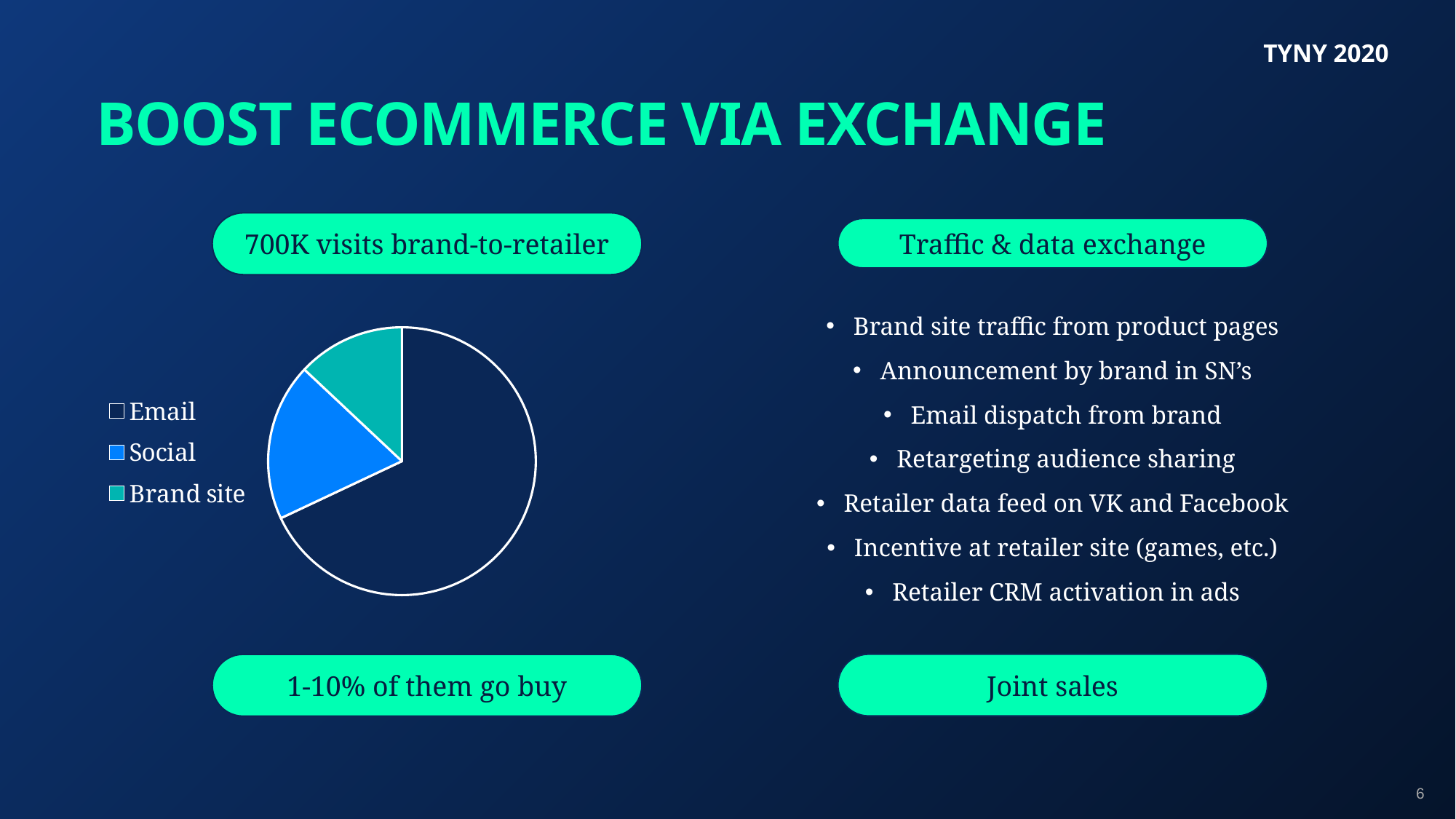
How many slices does the pie chart have? 3 Which slice is larger in the pie chart, Email or Social? Email Which slice is larger in the pie chart, Social or Brand site? Social What kind of chart is shown on the slide? pie chart How many entries does the pie chart's legend list? 3 Does the Email slice take up more or less than half of the pie chart? more Which category has the largest slice of the pie chart? Email Which legend entries are listed for the pie chart, from top to bottom? Email, Social, Brand site What colour is the Social slice in the pie chart? blue Which category has the smallest slice of the pie chart? Brand site